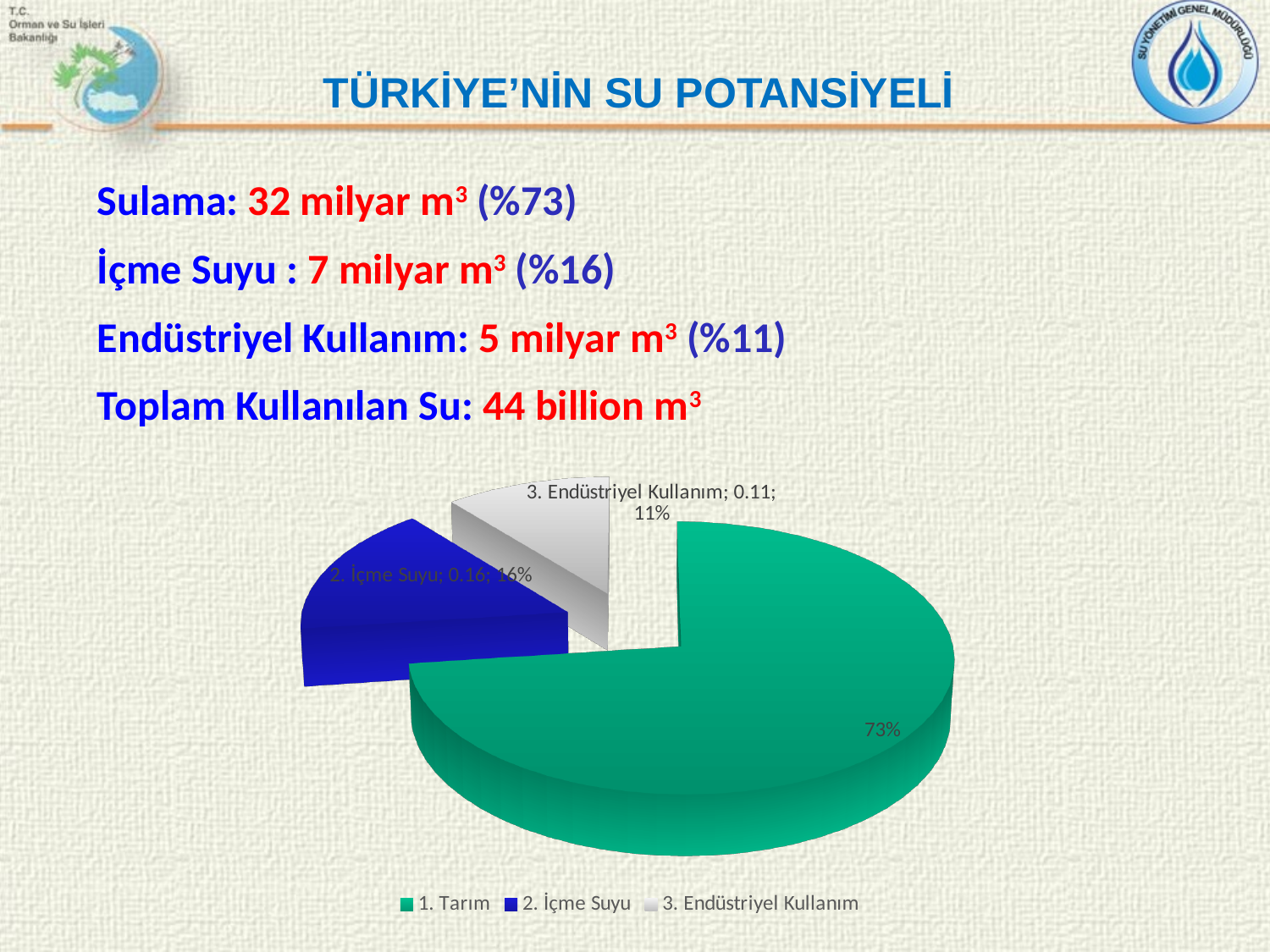
How many slices does the pie chart have? 3 Which colour is used for the 2. İçme Suyu slice in the pie chart? blue How many entries does the legend of the pie chart list? 3 What share of the pie does the slice for 2. İçme Suyu represent? 16% What value is printed in the data label for 3. Endüstriyel Kullanım? 0.11; 11% Which slice of the pie chart is the largest? 1. Tarım What share of the pie does the slice for 3. Endüstriyel Kullanım represent? 11% What is the difference in percentage points between the 1. Tarım slice and the 2. İçme Suyu slice? 57 What share of the pie does the slice for 1. Tarım represent? 73% What kind of chart is shown on the slide? pie chart What value is printed in the data label for 2. İçme Suyu? 0.16; 16% Which slice of the pie chart is the smallest? 3. Endüstriyel Kullanım